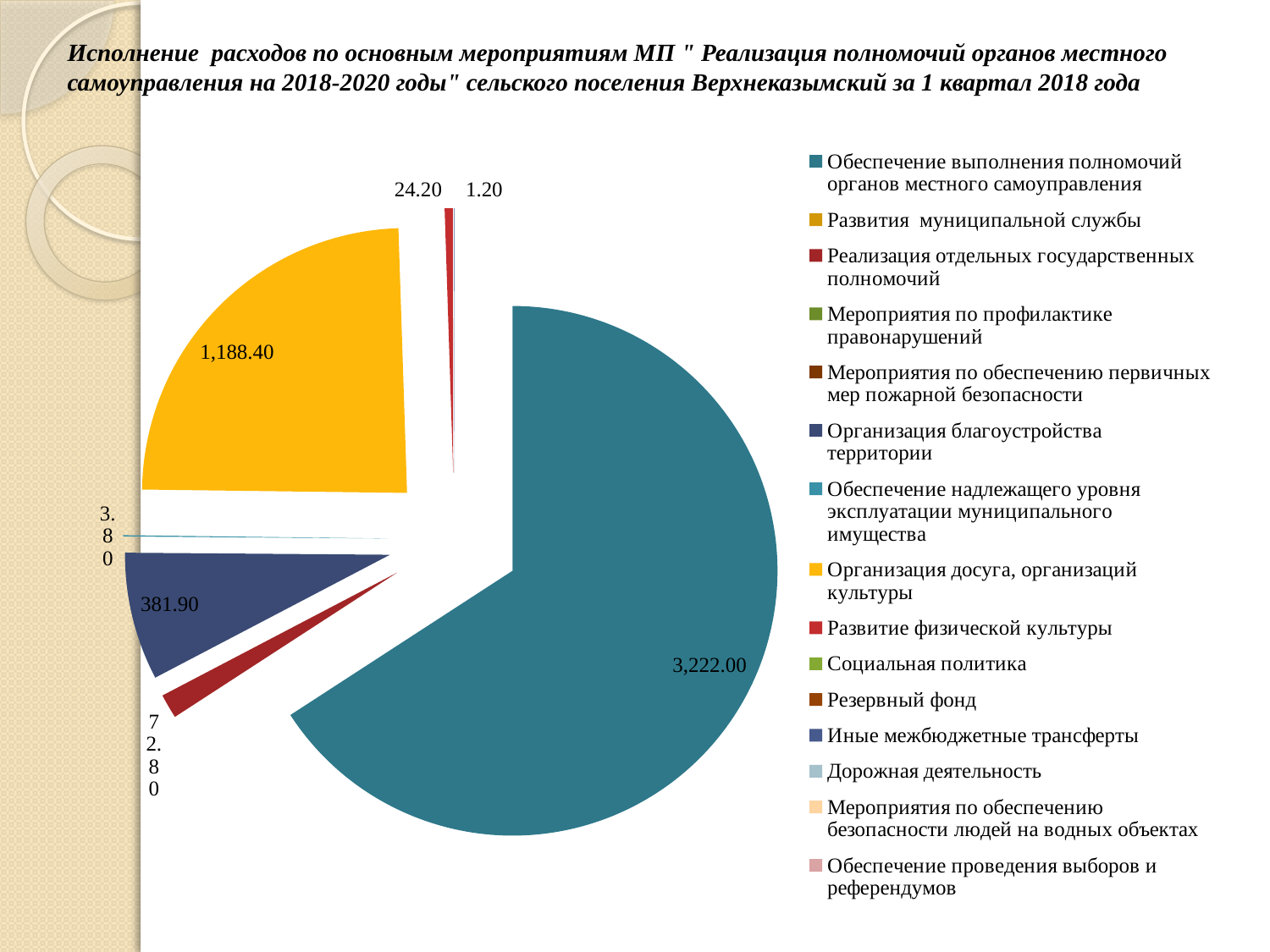
What is the value shown on the dark blue slice of the pie chart? 381.90 What is the difference between the slices labelled 24.20 and 1.20? 23.00 Which is larger: the slice labelled 381.90 or the slice labelled 72.80? 381.90 What is the value shown on the large yellow slice of the pie chart? 1,188.40 What type of chart is shown on the slide? Pie chart What is the smallest data label printed on the pie chart? 1.20 For which period does the chart show the execution of expenditures, according to the slide title? 1 квартал 2018 года Which category has the largest slice in the pie chart? Обеспечение выполнения полномочий органов местного самоуправления What is the value of the largest slice in the pie chart? 3,222.00 What is the difference between the largest slice (3,222.00) and the yellow slice (1,188.40)? 2,033.60 How many entries does the legend of the pie chart list? 15 How many slices of the pie chart have a printed data label? 7